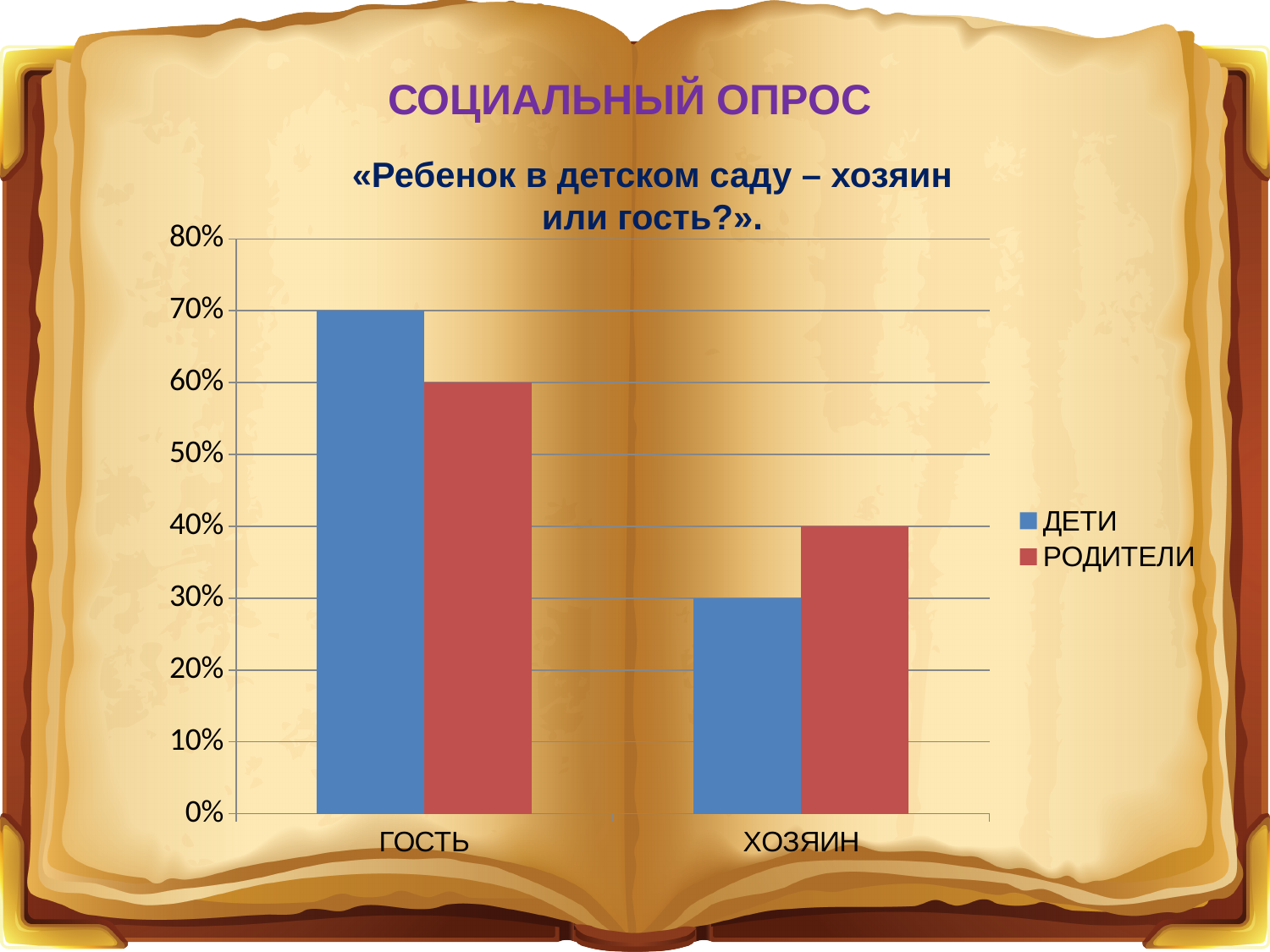
Which category has the lowest value for РОДИТЕЛИ? ХОЗЯИН What colour are the bars for the РОДИТЕЛИ series? red What is the value for РОДИТЕЛИ in the ХОЗЯИН category? 40% What is the value for РОДИТЕЛИ in the ГОСТЬ category? 60% What is the difference between the ДЕТИ and РОДИТЕЛИ values in the ГОСТЬ category? 10% How many series does the legend list? 2 What is the value for ДЕТИ in the ХОЗЯИН category? 30% What kind of chart is shown on the slide? bar chart How many categories are shown on the x axis? 2 What is the value for ДЕТИ in the ГОСТЬ category? 70% Which category has the highest value for ДЕТИ? ГОСТЬ In the ХОЗЯИН category, which series has the larger value, ДЕТИ or РОДИТЕЛИ? РОДИТЕЛИ